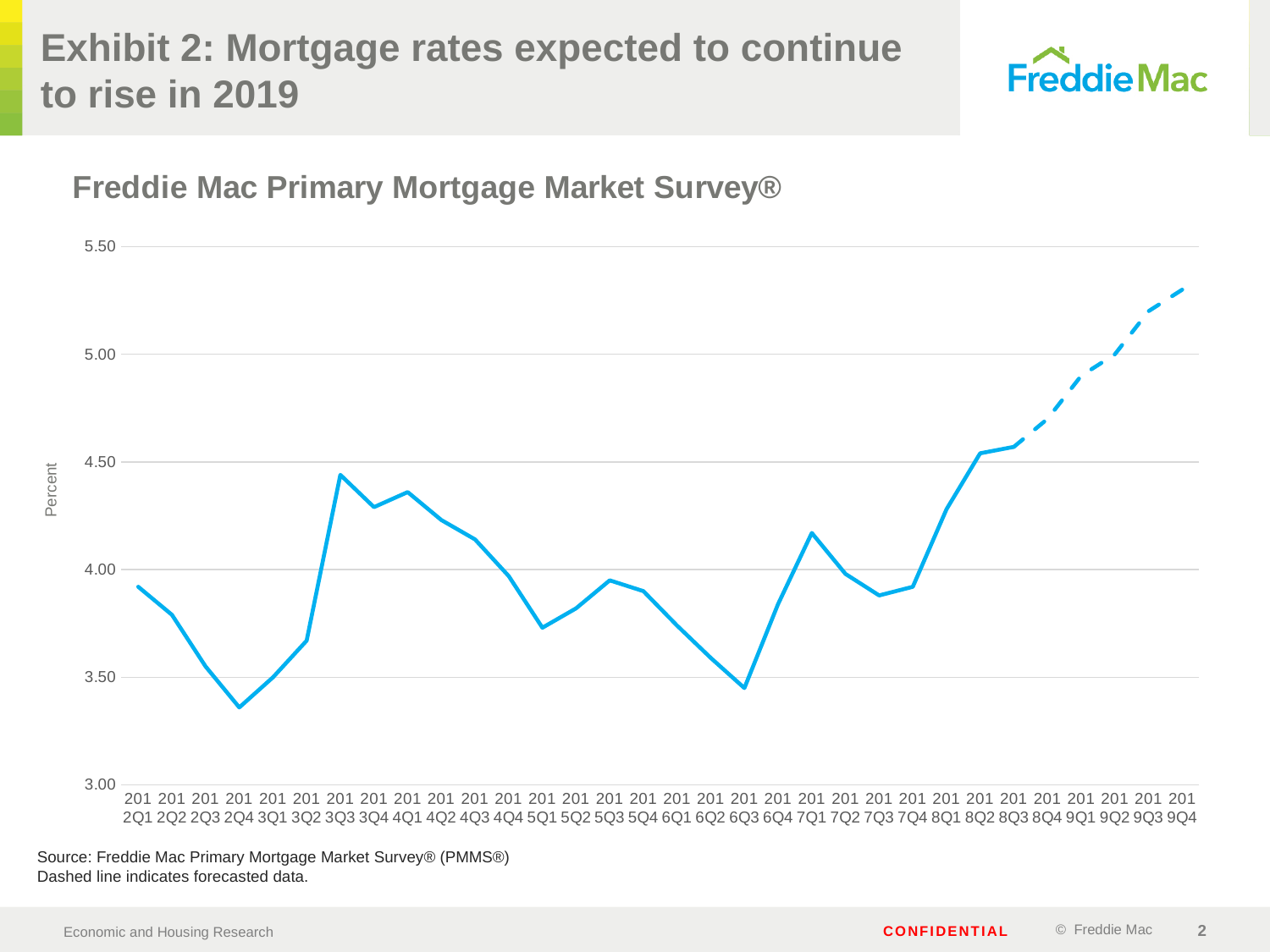
Is the value for 2016Q3 greater or less than 3.50? less What kind of chart is shown on the slide? Line chart Which is higher, the value for 2013Q3 or the value for 2017Q1? 2013Q3 Is the value for 2019Q4 greater or less than 5.00? greater What does the dashed portion of the line indicate? Forecasted data Which quarter has the lowest mortgage rate on the chart? 2012Q4 Which quarter has the highest mortgage rate on the chart? 2019Q4 What is the title of the chart? Freddie Mac Primary Mortgage Market Survey® Is the value for 2017Q1 greater or less than 4.00? greater How many quarterly data points are plotted on the chart? 32 Do the values rise or fall from 2018Q1 to 2019Q4? Rise